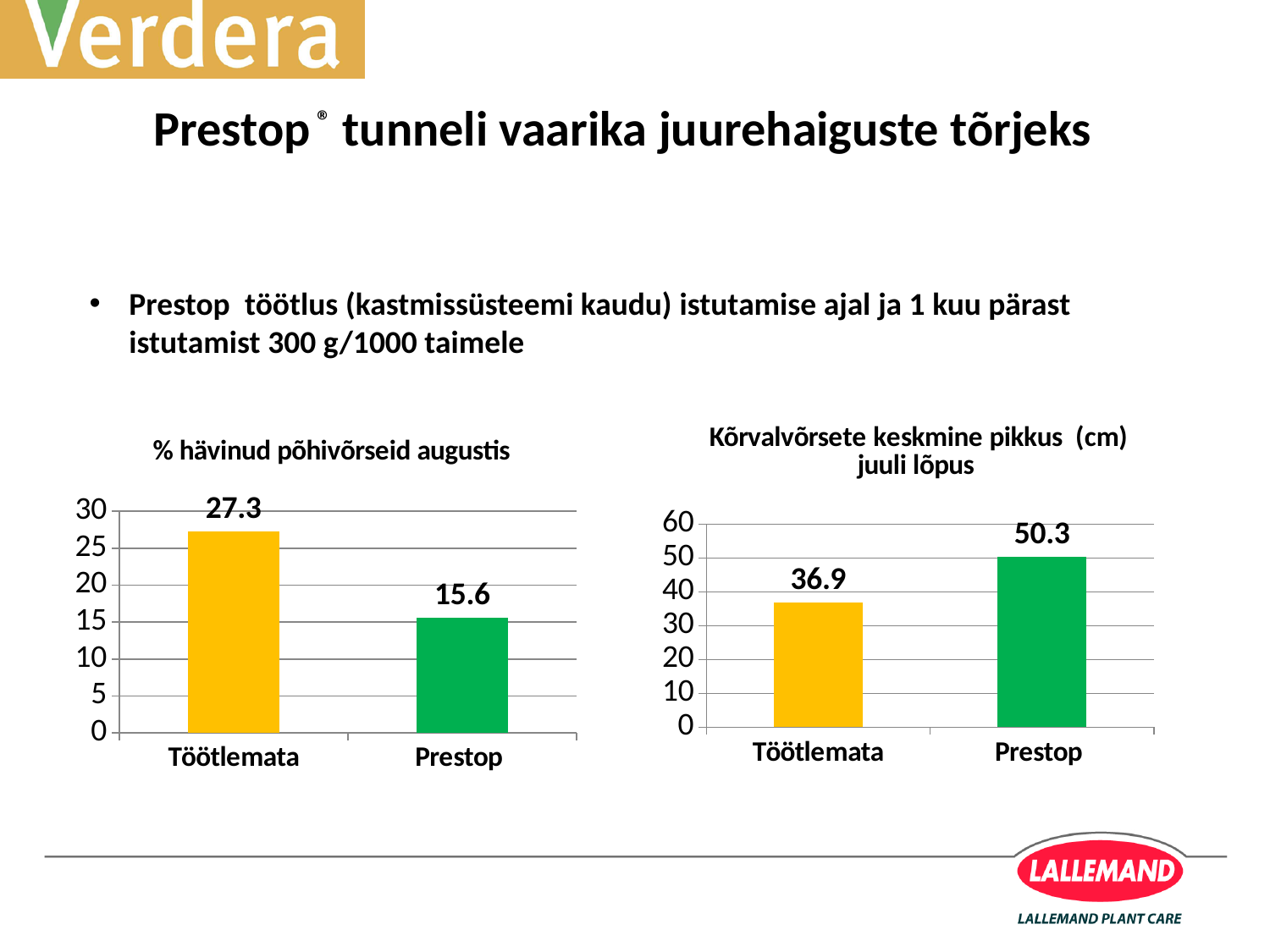
In the chart titled '% hävinud põhivõrseid augustis', what is the value for Prestop? 15.6 In the left chart, what is the difference between the Töötlemata and Prestop values? 11.7 In the right chart, which category has the lowest value? Töötlemata In the right chart, what is the difference between the Prestop and Töötlemata values? 13.4 How many categories are shown in the right chart? 2 What kind of chart is the left chart? bar chart In the left chart, which category has the highest value? Töötlemata In the chart titled 'Kõrvalvõrsete keskmine pikkus (cm) juuli lõpus', what is the value for Prestop? 50.3 In the left chart, is the value for Prestop greater or less than 20? less In the chart titled 'Kõrvalvõrsete keskmine pikkus (cm) juuli lõpus', what is the value for Töötlemata? 36.9 In the chart titled '% hävinud põhivõrseid augustis', what is the value for Töötlemata? 27.3 In the right chart, which is larger: Töötlemata or Prestop? Prestop